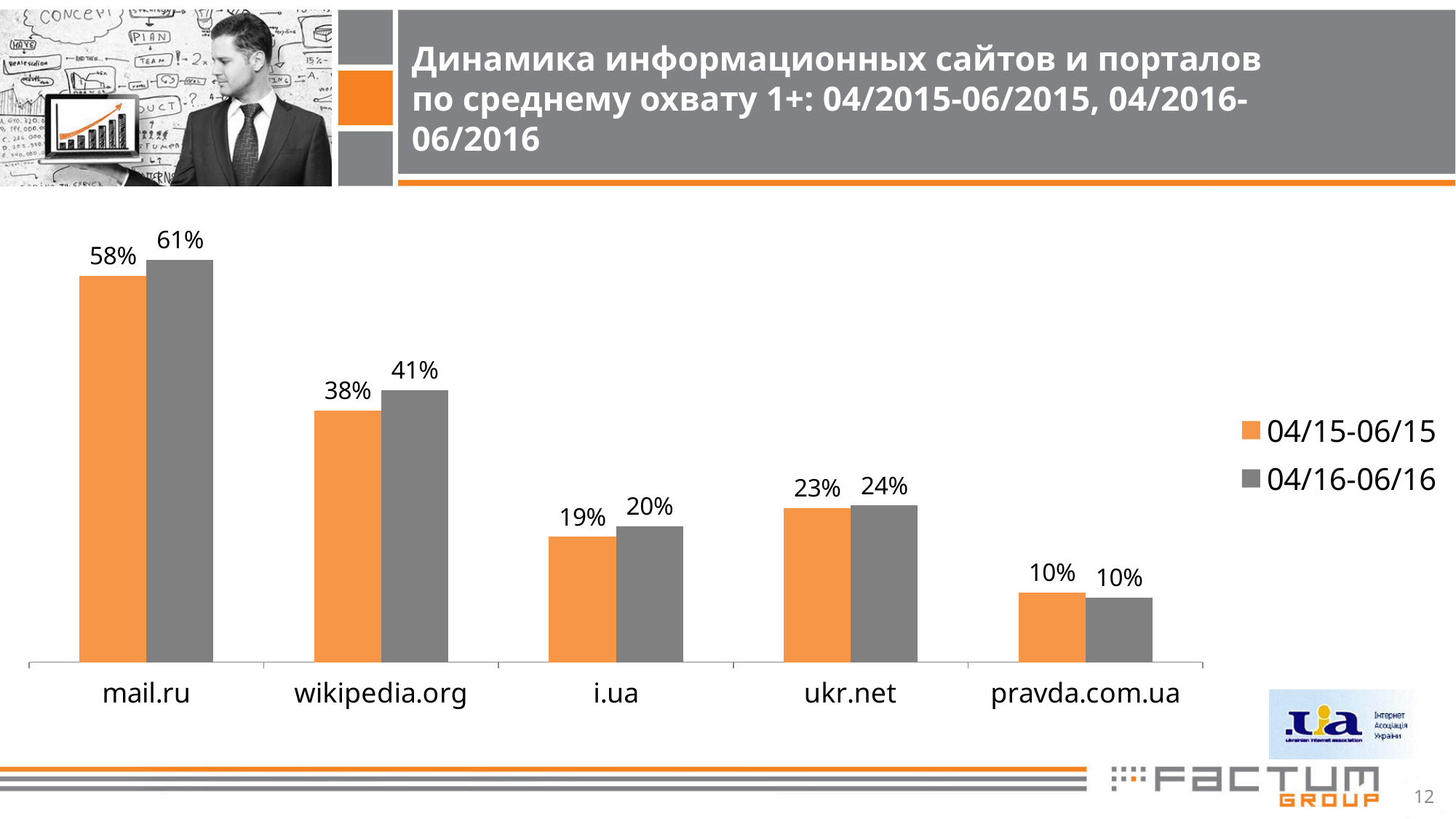
What is the value for ukr.net in the 04/15-06/15 series? 23% What is the difference between the 04/16-06/16 and 04/15-06/15 values for wikipedia.org? 3% What kind of chart is shown on the slide? bar chart How many sites are shown on the x axis? 5 Which colour represents the 04/15-06/15 series? orange Which is larger for mail.ru: the 04/15-06/15 value or the 04/16-06/16 value? 04/16-06/16 What is the value for i.ua in the 04/16-06/16 series? 20% What is the value for wikipedia.org in the 04/15-06/15 series? 38% What is the value for mail.ru in the 04/16-06/16 series? 61% How many series does the legend list? 2 Which site has the highest value in the 04/16-06/16 series? mail.ru Which site has the lowest value in the 04/15-06/15 series? pravda.com.ua